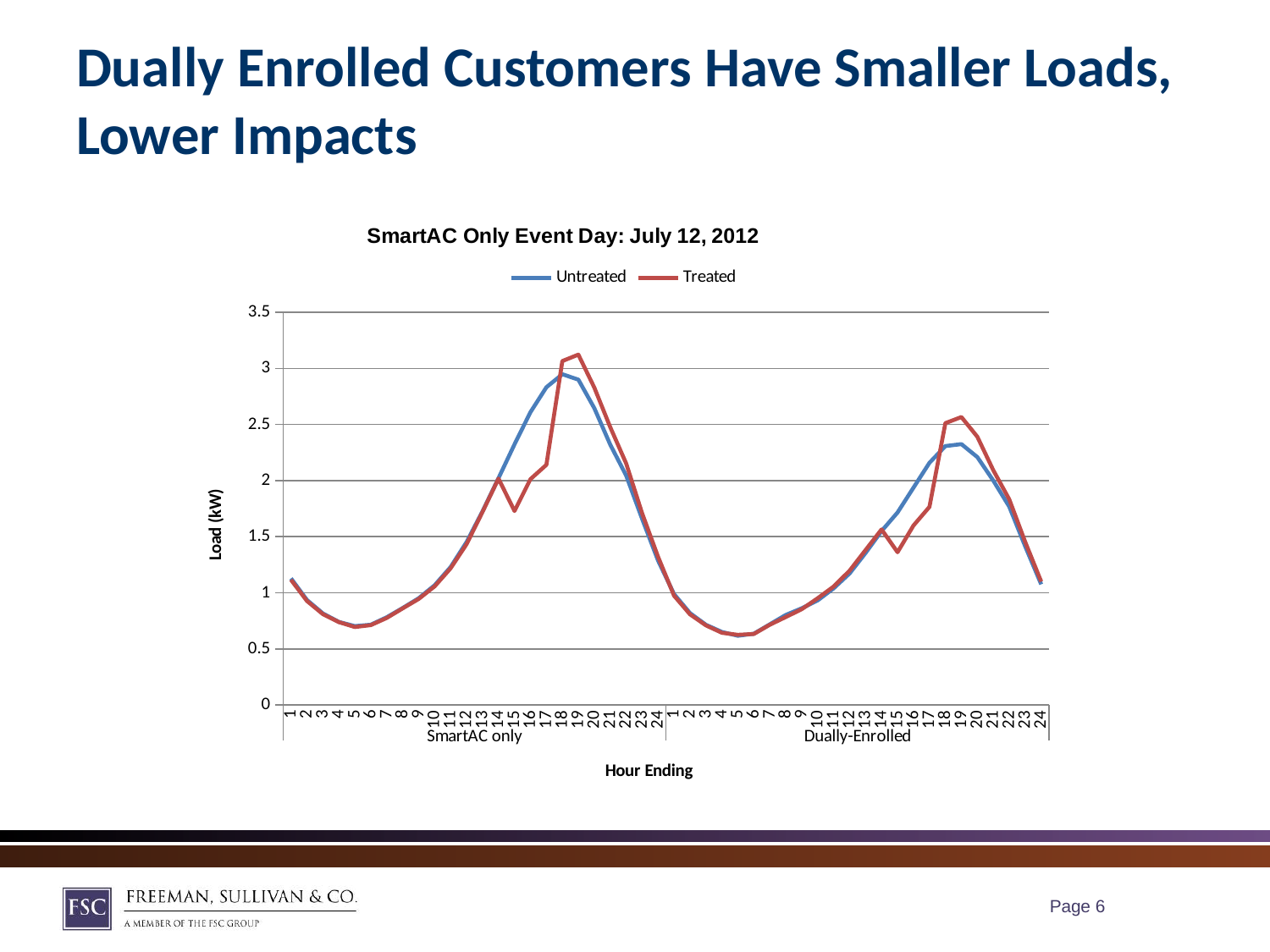
What is the title of the chart? SmartAC Only Event Day: July 12, 2012 How many hours are plotted for each customer group? 24 What kind of chart is shown on the slide? line chart Is the Untreated value at hour 19 for Dually-Enrolled greater or less than 2.5? less Do the Untreated values rise or fall from hour 5 to hour 18 for SmartAC only? rise Is the Treated value at hour 19 for SmartAC only greater or less than 3? greater What is the label of the vertical axis? Load (kW) Which group has the higher peak Treated load, SmartAC only or Dually-Enrolled? SmartAC only Is the Treated value at hour 5 for SmartAC only greater or less than 1? less How many series does the legend list? 2 How many customer groups are shown along the x axis? 2